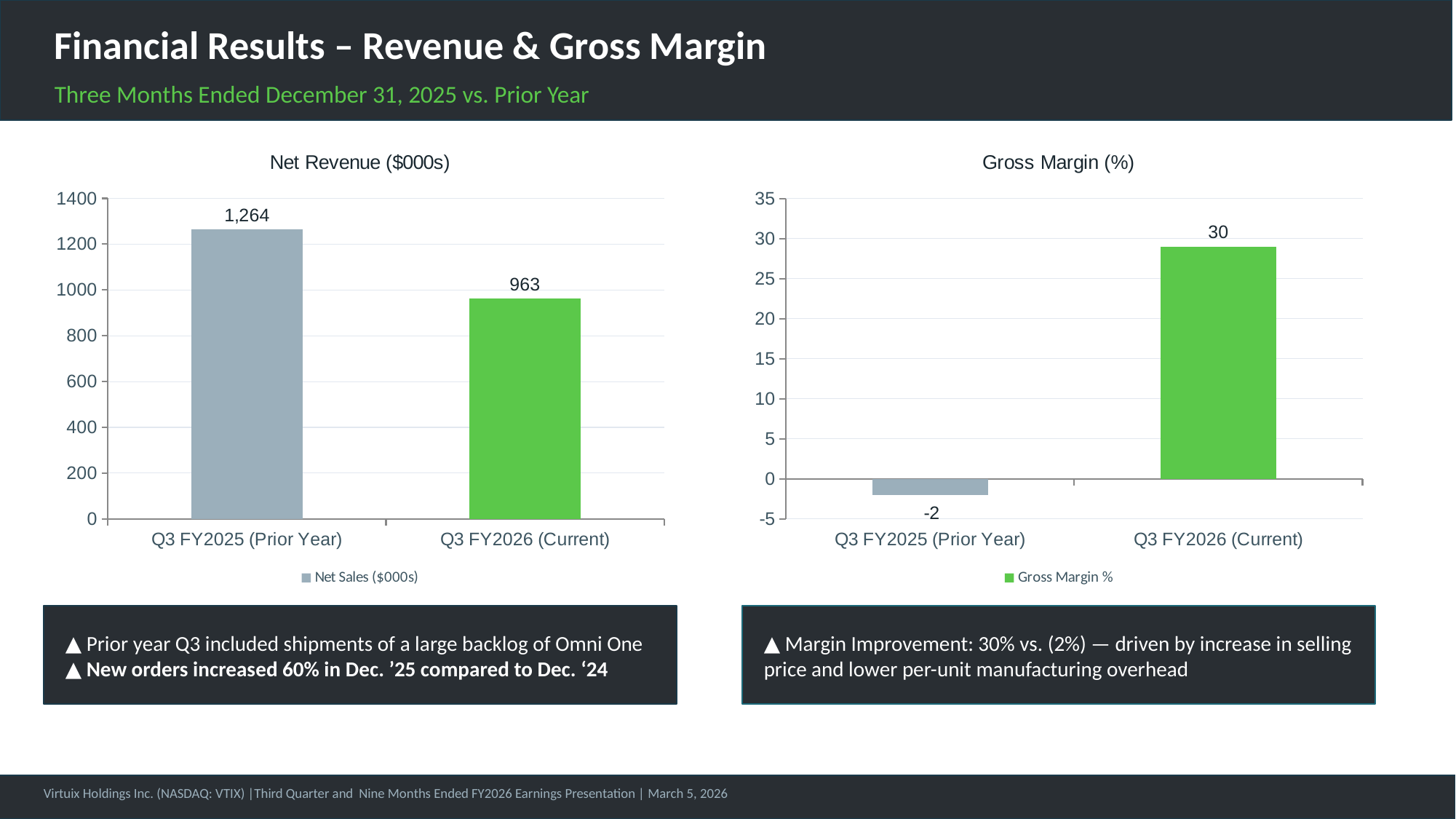
In the Gross Margin (%) chart, what is the difference between the Q3 FY2026 (Current) and Q3 FY2025 (Prior Year) values? 32 In the Gross Margin (%) chart, is the value for Q3 FY2026 (Current) greater or less than 25? greater How many categories are shown in the Net Revenue ($000s) chart? 2 In the Net Revenue ($000s) chart, what is the difference between the Q3 FY2025 (Prior Year) and Q3 FY2026 (Current) values? 301 In the Gross Margin (%) chart, what is the value for Q3 FY2026 (Current)? 30 In the Gross Margin (%) chart, what is the value for Q3 FY2025 (Prior Year)? -2 What type of chart is the Gross Margin (%) chart? bar chart In the Net Revenue ($000s) chart, do the values rise or fall from Q3 FY2025 to Q3 FY2026? fall In the Net Revenue ($000s) chart, which category has the higher value? Q3 FY2025 (Prior Year) In the Gross Margin (%) chart, which category has the lowest value? Q3 FY2025 (Prior Year) In the Net Revenue ($000s) chart, what is the value for Q3 FY2025 (Prior Year)? 1,264 In the Net Revenue ($000s) chart, what is the value for Q3 FY2026 (Current)? 963